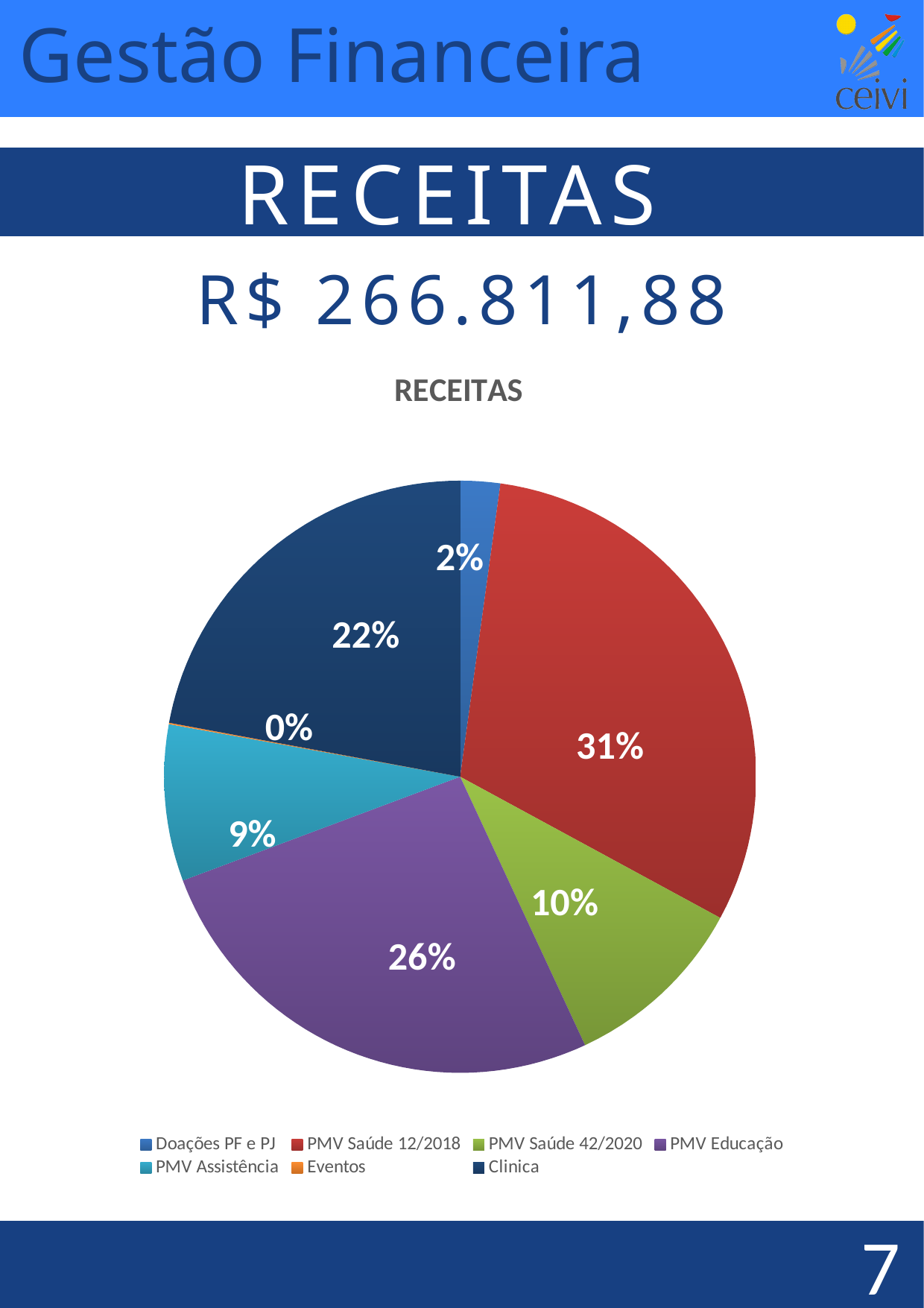
What is the difference in percentage points between PMV Saúde 12/2018 and PMV Educação? 5% What share of the pie does PMV Saúde 12/2018 represent? 31% What kind of chart is shown on the slide? pie chart Which is larger, the share for PMV Saúde 42/2020 or the share for PMV Assistência? PMV Saúde 42/2020 How many categories does the legend list? 7 What share of the pie does Doações PF e PJ represent? 2% What share of the pie does PMV Assistência represent? 9% What is the title of the chart? RECEITAS Which category has the largest slice of the pie? PMV Saúde 12/2018 Which category has the smallest slice of the pie? Eventos